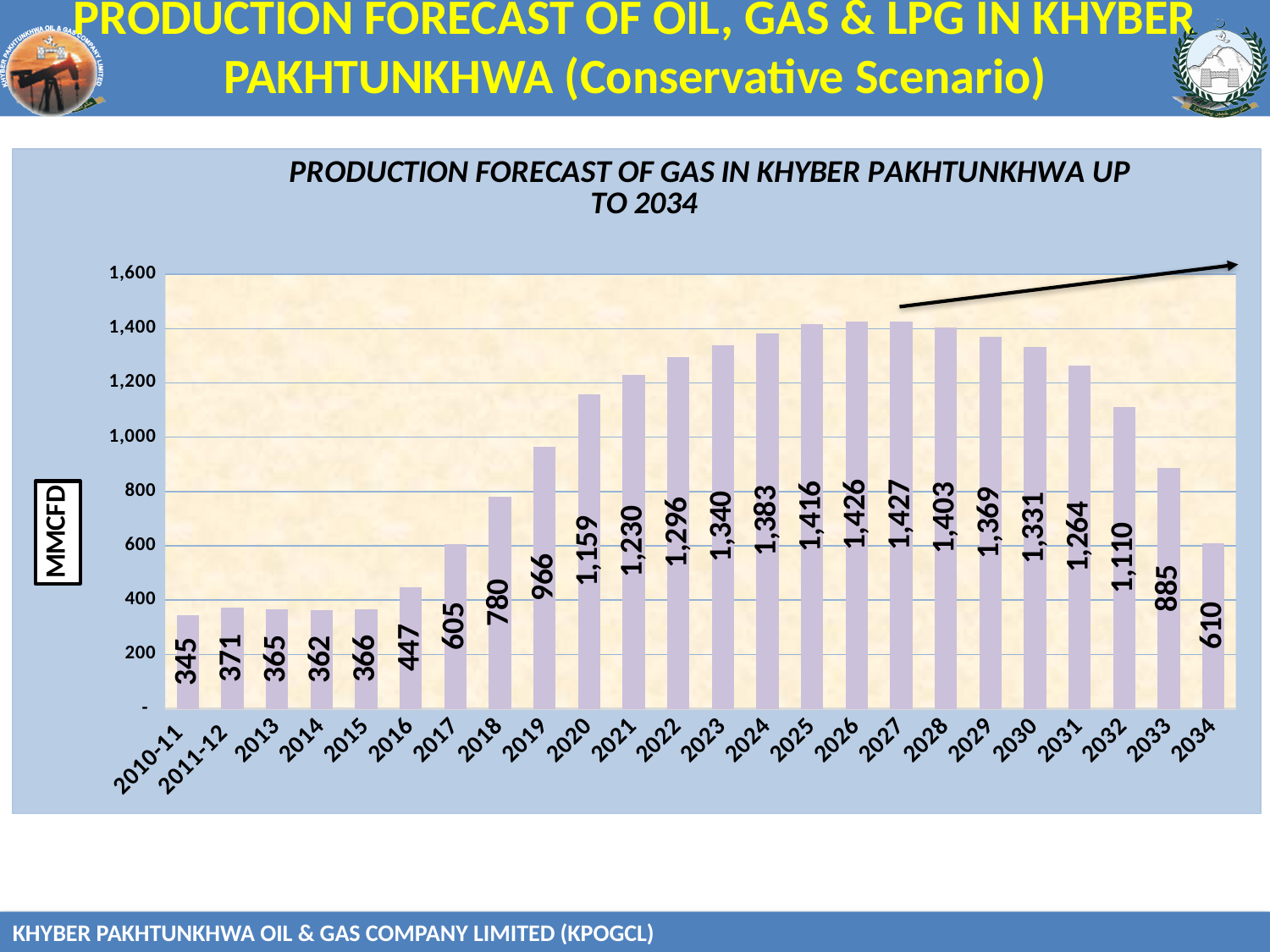
How many years (bars) are shown on the chart? 24 What is the gas production forecast value for 2019? 966 Do the values rise or fall from 2027 to 2034? fall What value is shown for 2024? 1,383 Is the value for 2020 greater or less than 1,000? greater Which year has the lowest forecast value? 2010-11 Which is larger, the value for 2018 or the value for 2033? 2033 What is the value for 2016? 447 What kind of chart is shown on the slide? bar chart What is the difference between the values for 2027 and 2010-11? 1,082 What is the difference between the values for 2032 and 2033? 225 What is the forecast value shown for 2034? 610